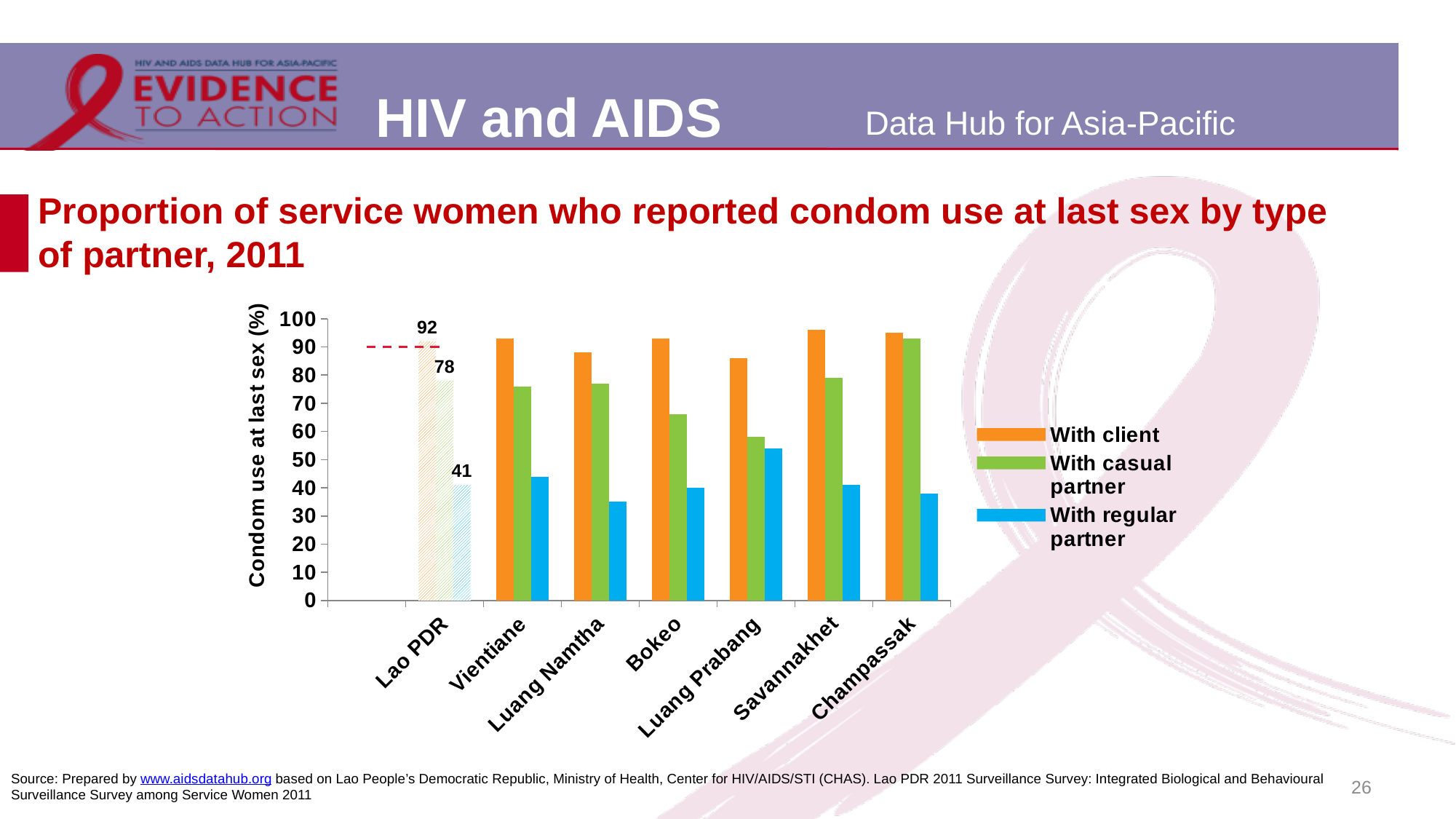
What is the value for Lao PDR in the 'With casual partner' series? 78 Which category has the highest 'With casual partner' value? Champassak How many categories are shown on the x axis of the chart? 7 Is the 'With casual partner' value for Luang Prabang greater or less than 50? greater For Lao PDR, what is the difference between the 'With client' value and the 'With casual partner' value? 14 What kind of chart is shown on the slide? Bar chart For Lao PDR, what is the difference between the 'With client' value and the 'With regular partner' value? 51 Is the 'With regular partner' value for Luang Namtha greater or less than 40? less What is the value for Lao PDR in the 'With client' series? 92 How many series does the legend list? 3 What is the value for Lao PDR in the 'With regular partner' series? 41 Which has the larger 'With casual partner' value, Champassak or Bokeo? Champassak